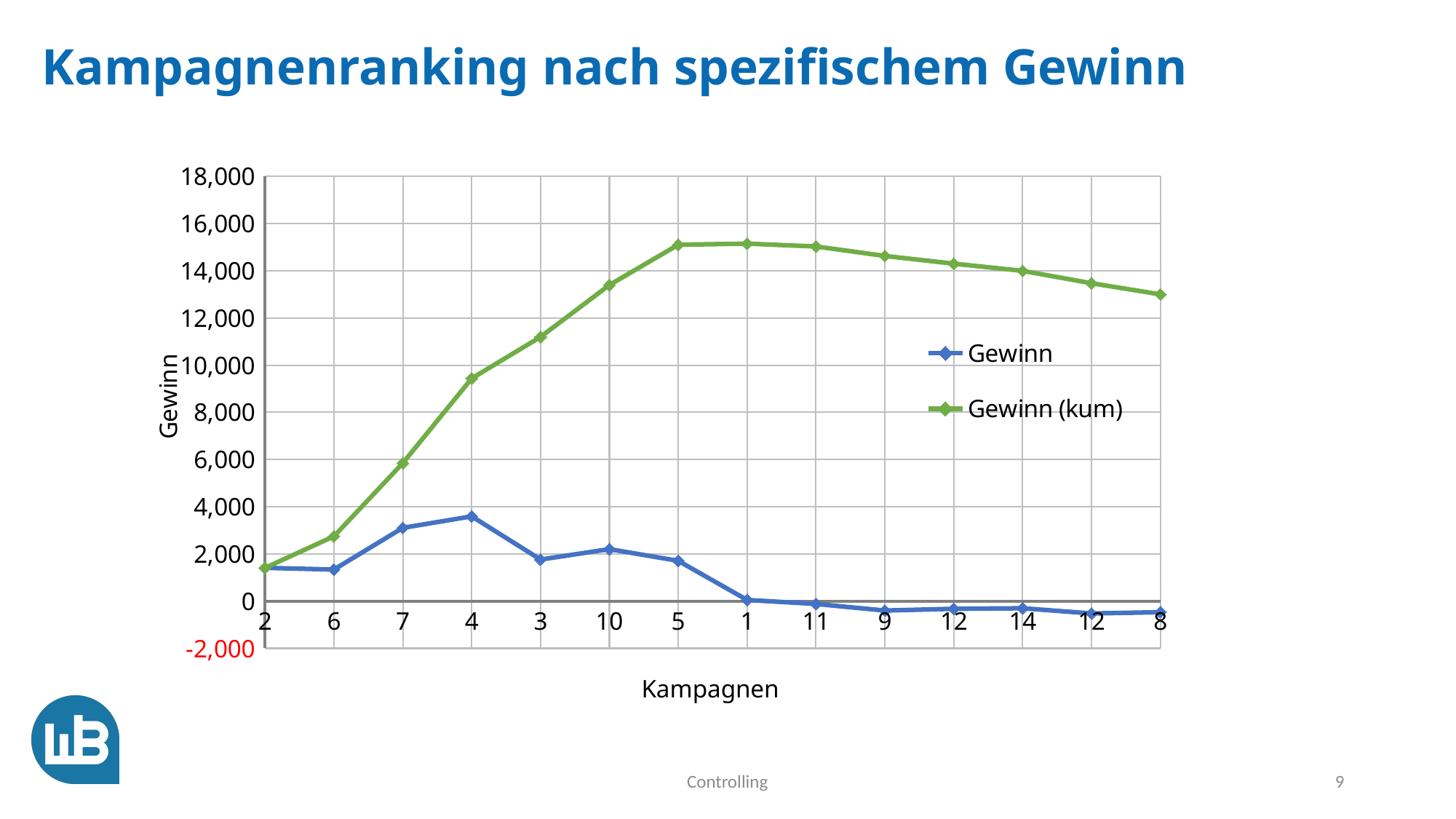
What is the title of the chart's x axis? Kampagnen Which is larger, the Gewinn value for campaign 7 or for campaign 6? campaign 7 How many campaigns are plotted along the x axis? 14 Does the Gewinn (kum) line rise or fall from campaign 2 to campaign 5? rise Is the Gewinn value for campaign 4 greater or less than 4,000? less Is the Gewinn (kum) value for campaign 10 greater or less than 12,000? greater Is the Gewinn value for campaign 9 greater or less than 0? less What kind of chart is shown on the slide? line chart Which campaign has the lowest Gewinn (kum) value? 2 Which campaign has the highest Gewinn value? 4 How many series does the legend list? 2